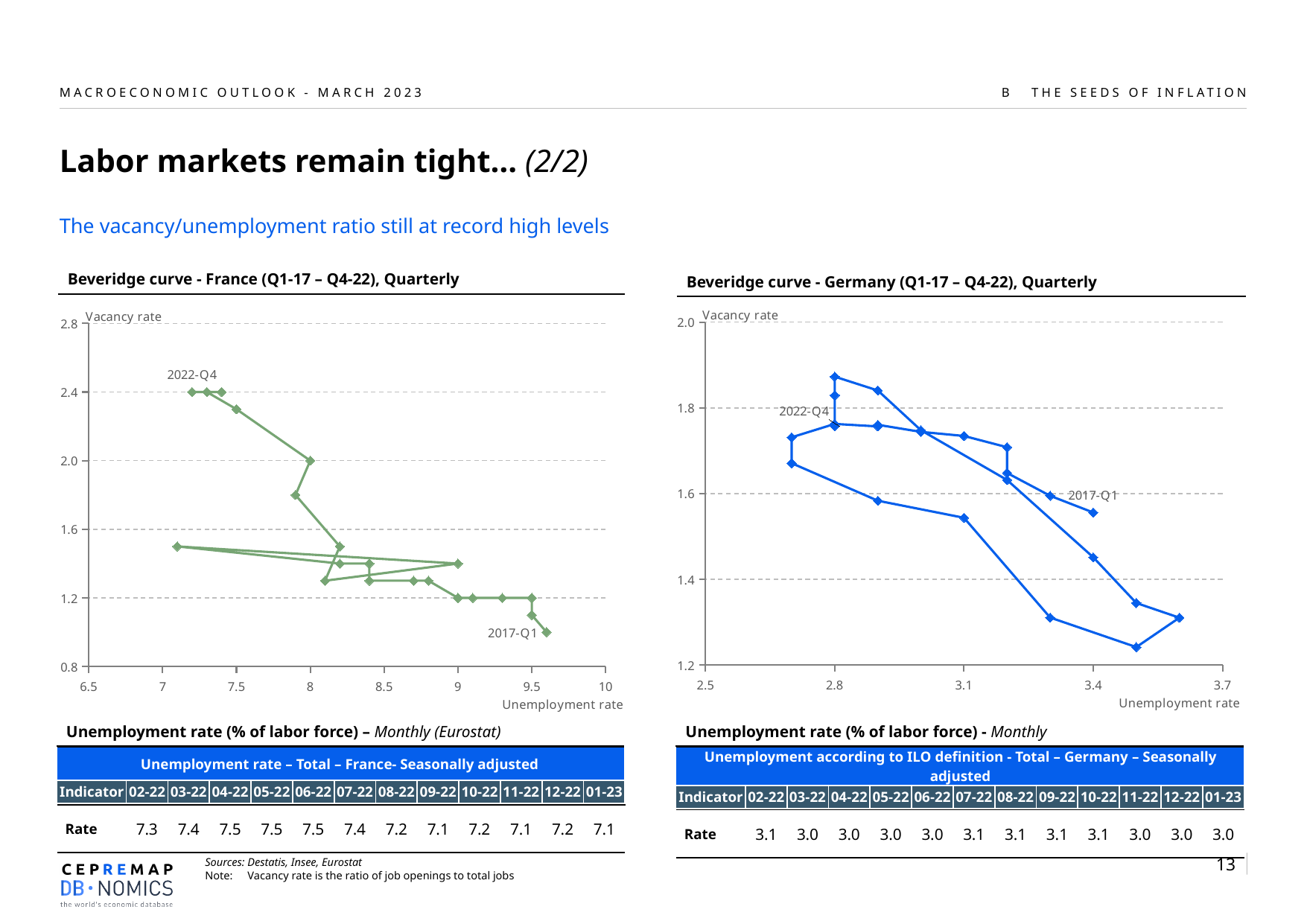
On the 'Beveridge curve - Germany' chart, is the vacancy rate at 2022-Q4 greater or less than 1.6? greater On the 'Beveridge curve - France' chart, as the unemployment rate increases along the x axis, does the vacancy rate generally rise or fall? fall On the 'Beveridge curve - France' chart, is the vacancy rate at 2022-Q4 greater or less than 2.0? greater On the 'Beveridge curve - France' chart, is the vacancy rate at 2017-Q1 greater or less than 1.2? less On the 'Beveridge curve - Germany' chart, what is the label of the y axis? Vacancy rate On the 'Beveridge curve - France' chart, what is the label of the x axis? Unemployment rate On the 'Beveridge curve - Germany' chart, is the vacancy rate at 2022-Q4 higher or lower than at 2017-Q1? higher What kind of chart is the 'Beveridge curve - France' chart? line chart